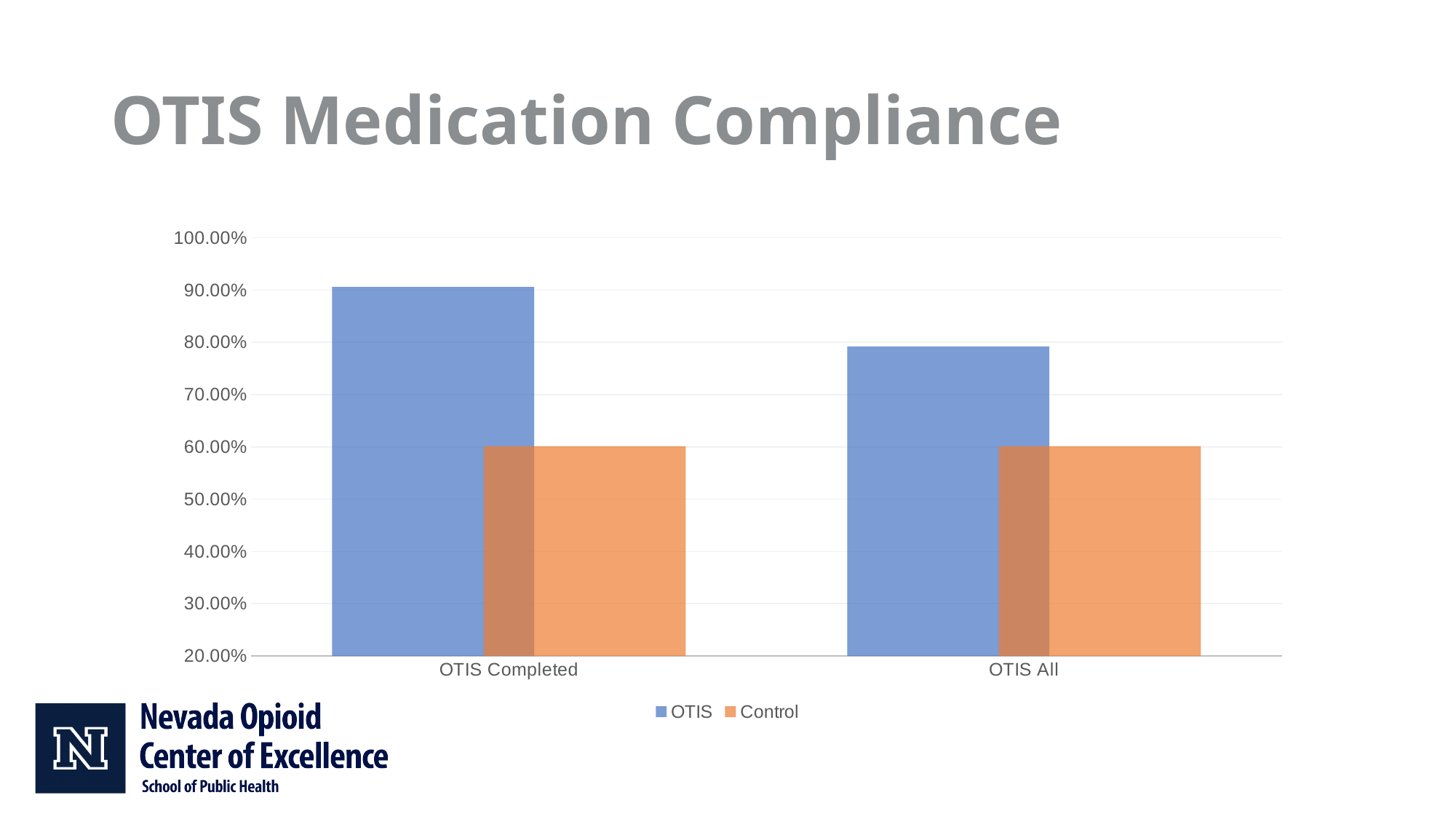
How many categories are shown on the x axis? 2 Is the OTIS value for OTIS Completed greater or less than 80.00%? greater Does the OTIS series rise or fall from OTIS Completed to OTIS All? fall What is the title of the chart on the slide? OTIS Medication Compliance What kind of chart is shown on the slide? bar chart For OTIS Completed, which is larger, the OTIS bar or the Control bar? OTIS Which series is shown in orange in the legend? Control Which category has the highest OTIS bar? OTIS Completed How many series does the legend list? 2 Is the OTIS value for OTIS All greater or less than 70.00%? greater